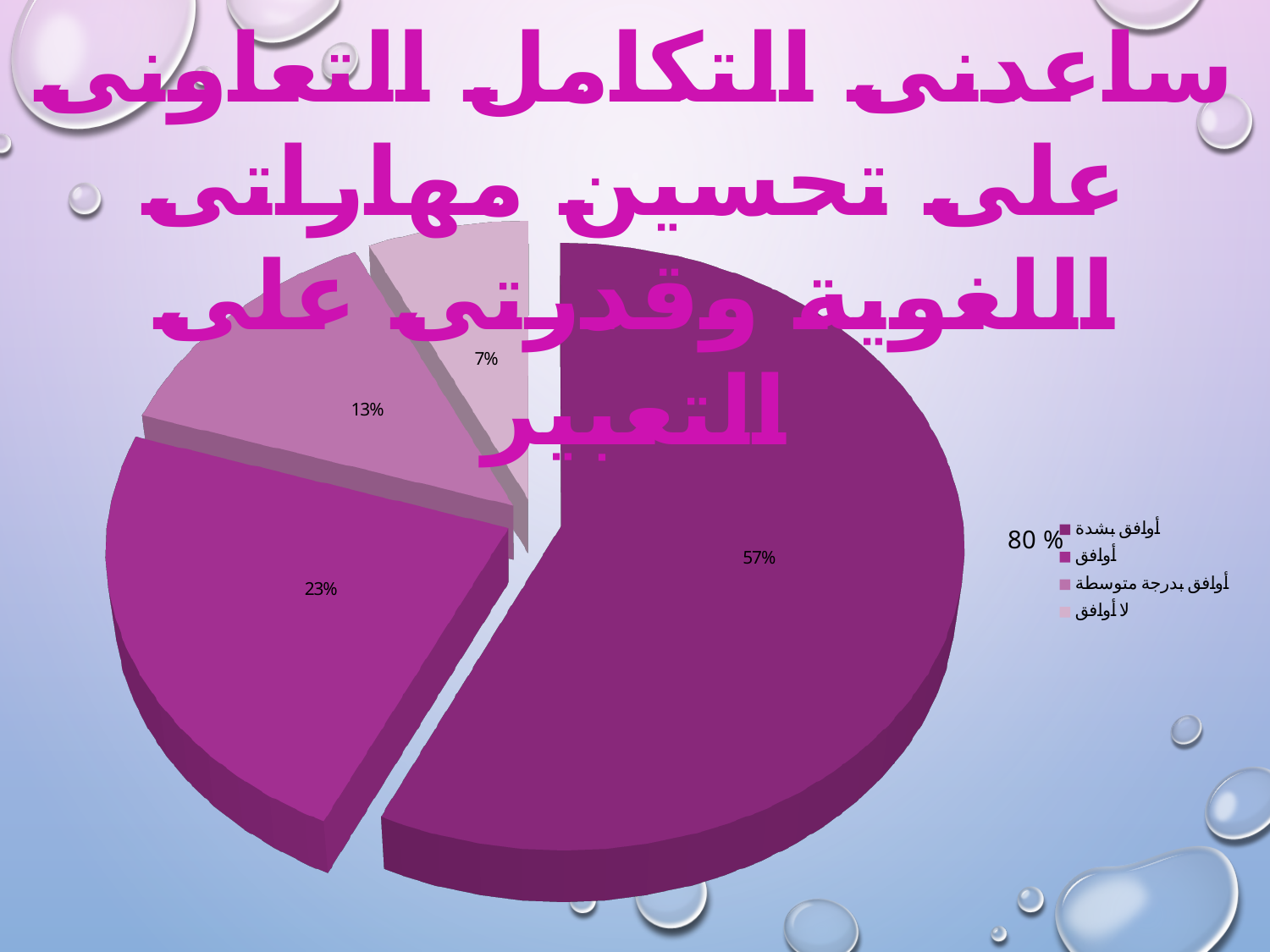
Which legend entry is shown with the lightest colour? لا أوافق Which slice is larger, أوافق بدرجة متوسطة or لا أوافق? أوافق بدرجة متوسطة Which category has the smallest slice of the pie? لا أوافق How many entries does the legend of the pie chart list? 4 What kind of chart is shown on the slide? pie chart Which category has the largest slice of the pie? أوافق بشدة What share of the pie does the slice for أوافق represent? 23% What share of the pie does the slice for أوافق بشدة represent? 57% How many slices does the pie chart have? 4 What share of the pie does the slice for لا أوافق represent? 7% What is the difference in percentage points between the أوافق بشدة slice and the أوافق slice? 34